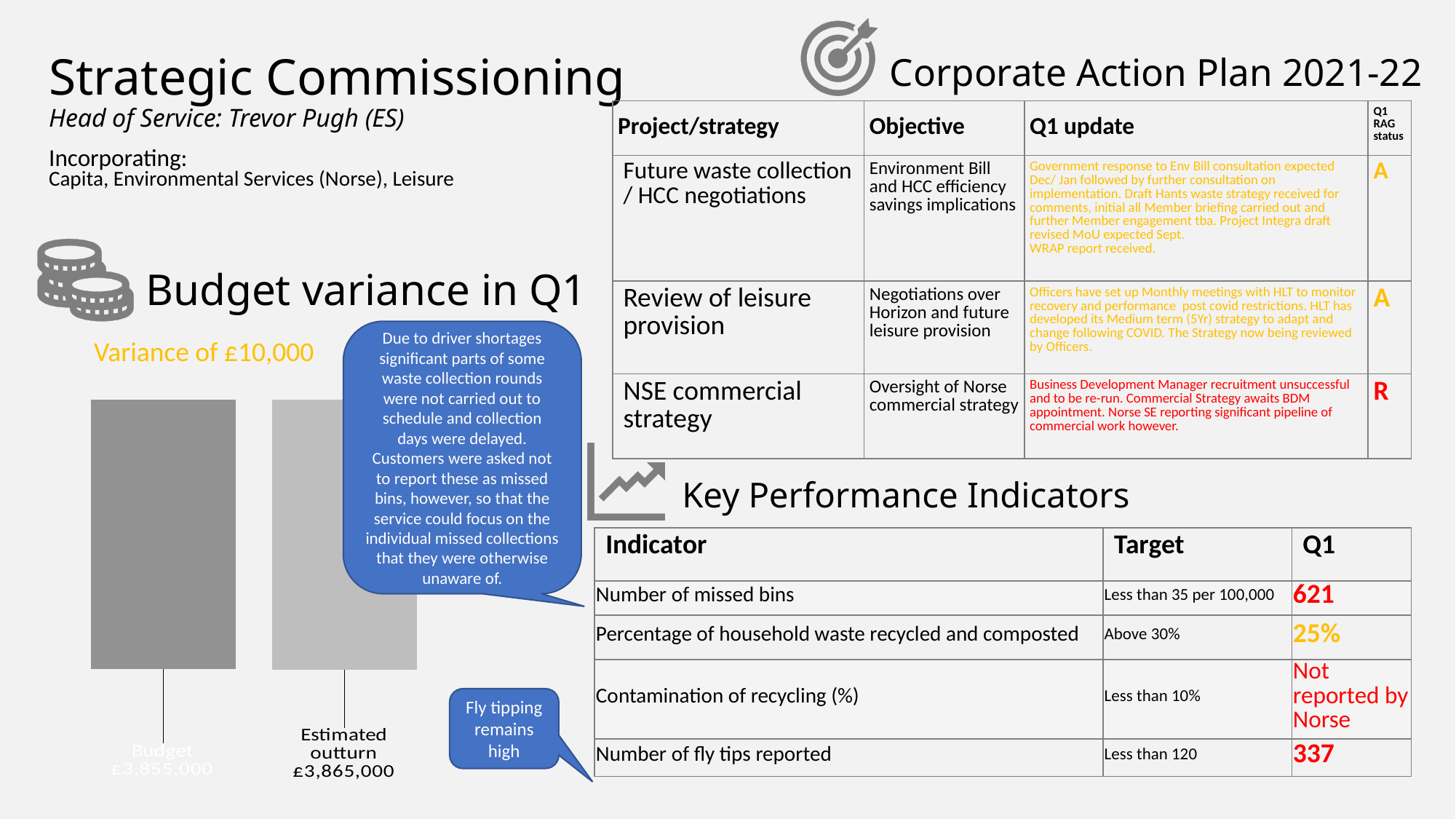
What variance amount is stated above the 'Budget variance in Q1' chart? Variance of £10,000 What is the value of the Budget bar in the 'Budget variance in Q1' chart? £3,855,000 How many bars does the 'Budget variance in Q1' chart show? 2 What is the title of the chart on the slide? Budget variance in Q1 Do the values in the 'Budget variance in Q1' chart rise or fall from Budget to Estimated outturn? rise What kind of chart is shown under the heading 'Budget variance in Q1'? bar chart In the 'Budget variance in Q1' chart, which category has the lowest value? Budget In the 'Budget variance in Q1' chart, which bar has the higher value, Budget or Estimated outturn? Estimated outturn What is the value of the Estimated outturn bar in the 'Budget variance in Q1' chart? £3,865,000 What is the difference between the Estimated outturn and the Budget in the 'Budget variance in Q1' chart? £10,000